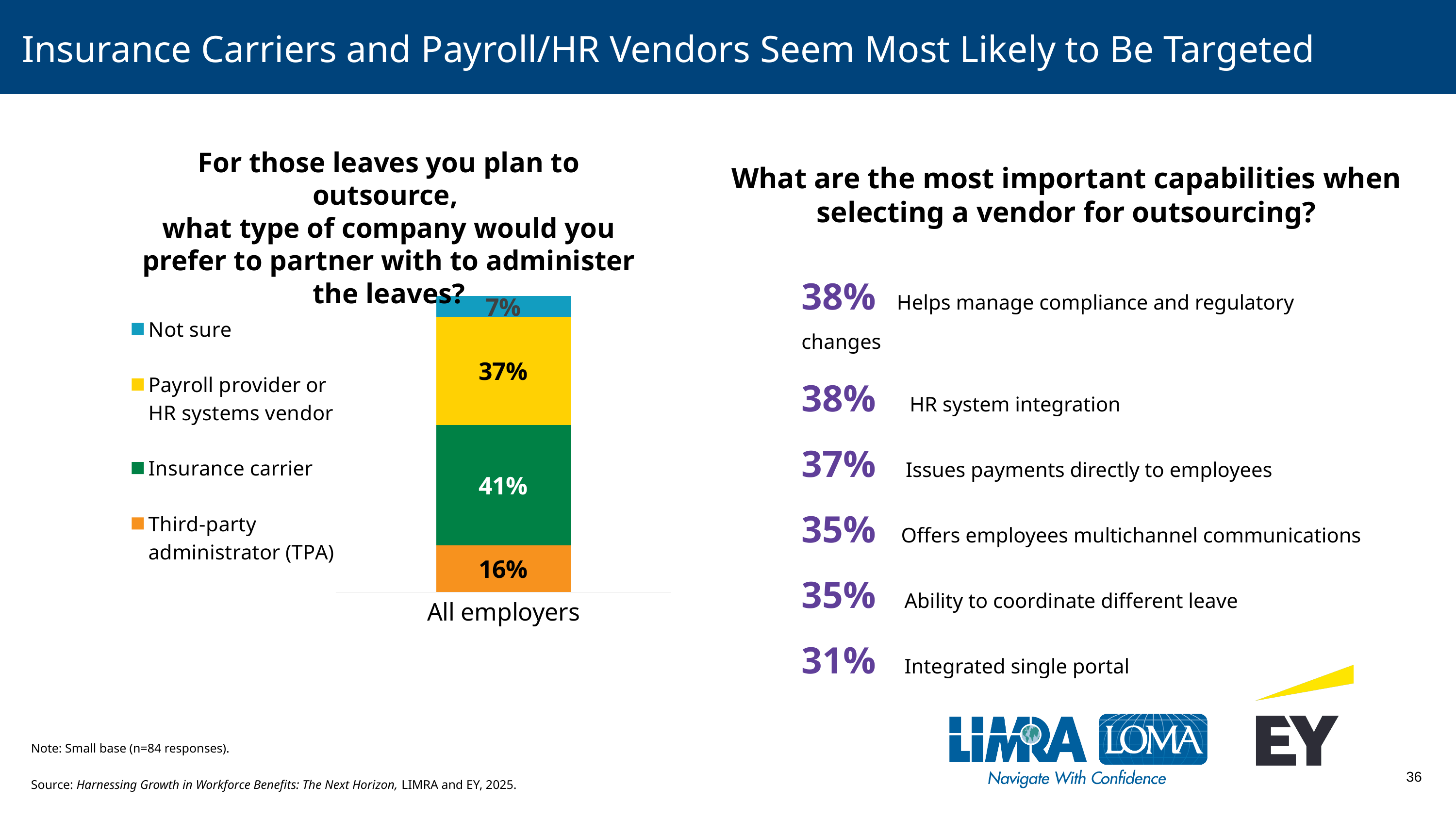
What colour is the segment representing the insurance carrier in the stacked bar? Green What percentage of employers prefer a third-party administrator (TPA)? 16% What percentage of employers prefer a payroll provider or HR systems vendor? 37% What is the label on the x axis under the stacked bar? All employers Which is larger: the share for insurance carrier or the share for payroll provider or HR systems vendor? Insurance carrier What is the difference in percentage points between the insurance carrier segment and the third-party administrator (TPA) segment? 25 How many categories does the legend of the stacked bar chart list? 4 What percentage of employers prefer to partner with an insurance carrier to administer outsourced leaves? 41% Which type of company has the largest share of employers preferring it? Insurance carrier What kind of chart is used to show the preferred type of company to partner with? Stacked bar chart What percentage of employers answered 'Not sure' about which type of company they would prefer to partner with? 7% Which legend category has the smallest segment in the stacked bar? Not sure